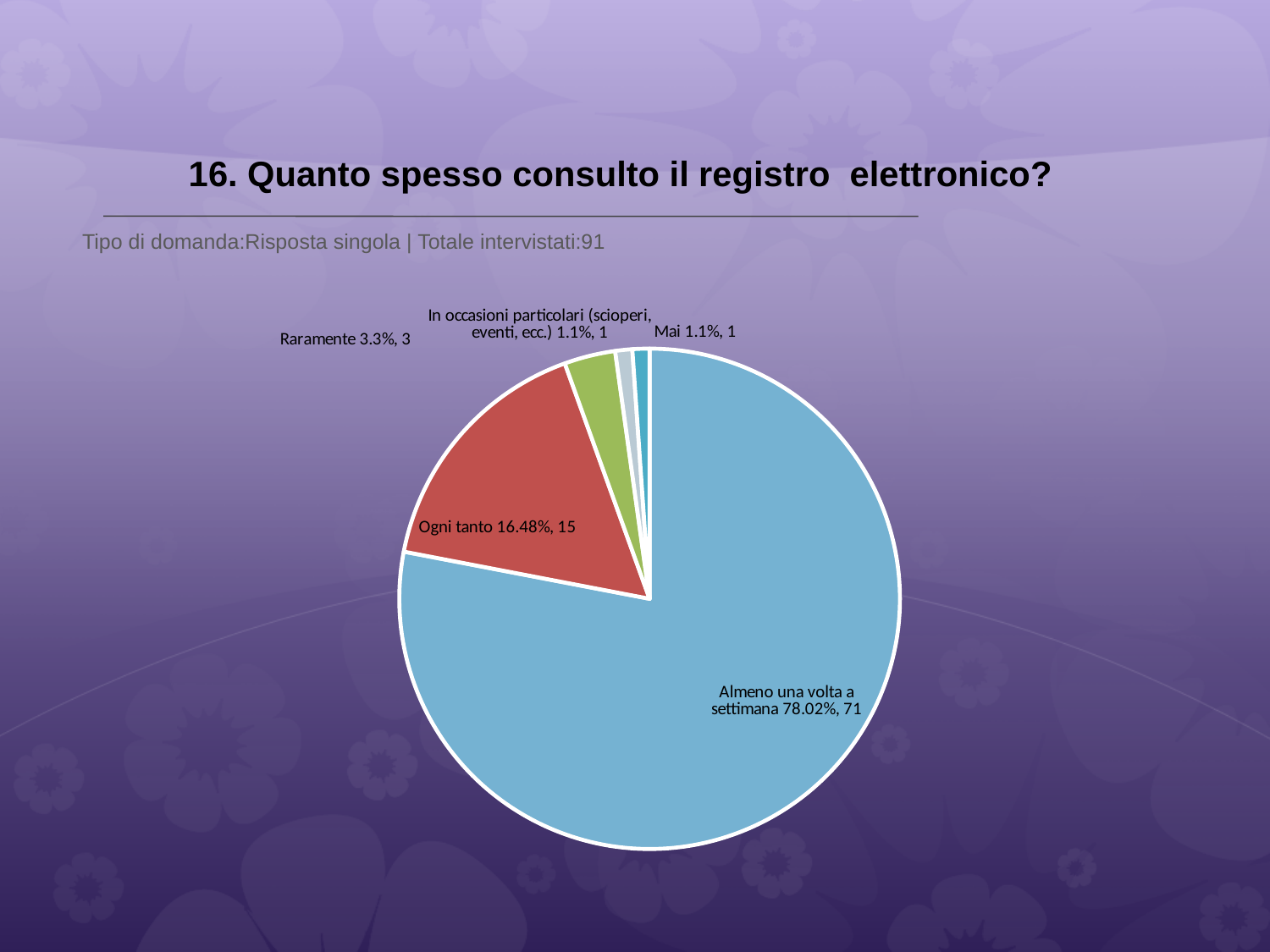
Which is larger, the slice for "Ogni tanto" or the slice for "Raramente"? Ogni tanto What percentage share does the slice "Almeno una volta a settimana" have? 78.02% What kind of chart is shown on the slide? pie chart What is the total number of respondents shown on the slide? 91 What is the title of the chart on the slide? 16. Quanto spesso consulto il registro elettronico? How many respondents chose "Ogni tanto"? 15 How many slices does the pie chart have? 5 What percentage share does the slice "Mai" have? 1.1% How many respondents chose "Raramente"? 3 What is the difference in respondent count between "Almeno una volta a settimana" and "Ogni tanto"? 56 What percentage share does the slice "Ogni tanto" have? 16.48% Which category has the largest slice of the pie? Almeno una volta a settimana